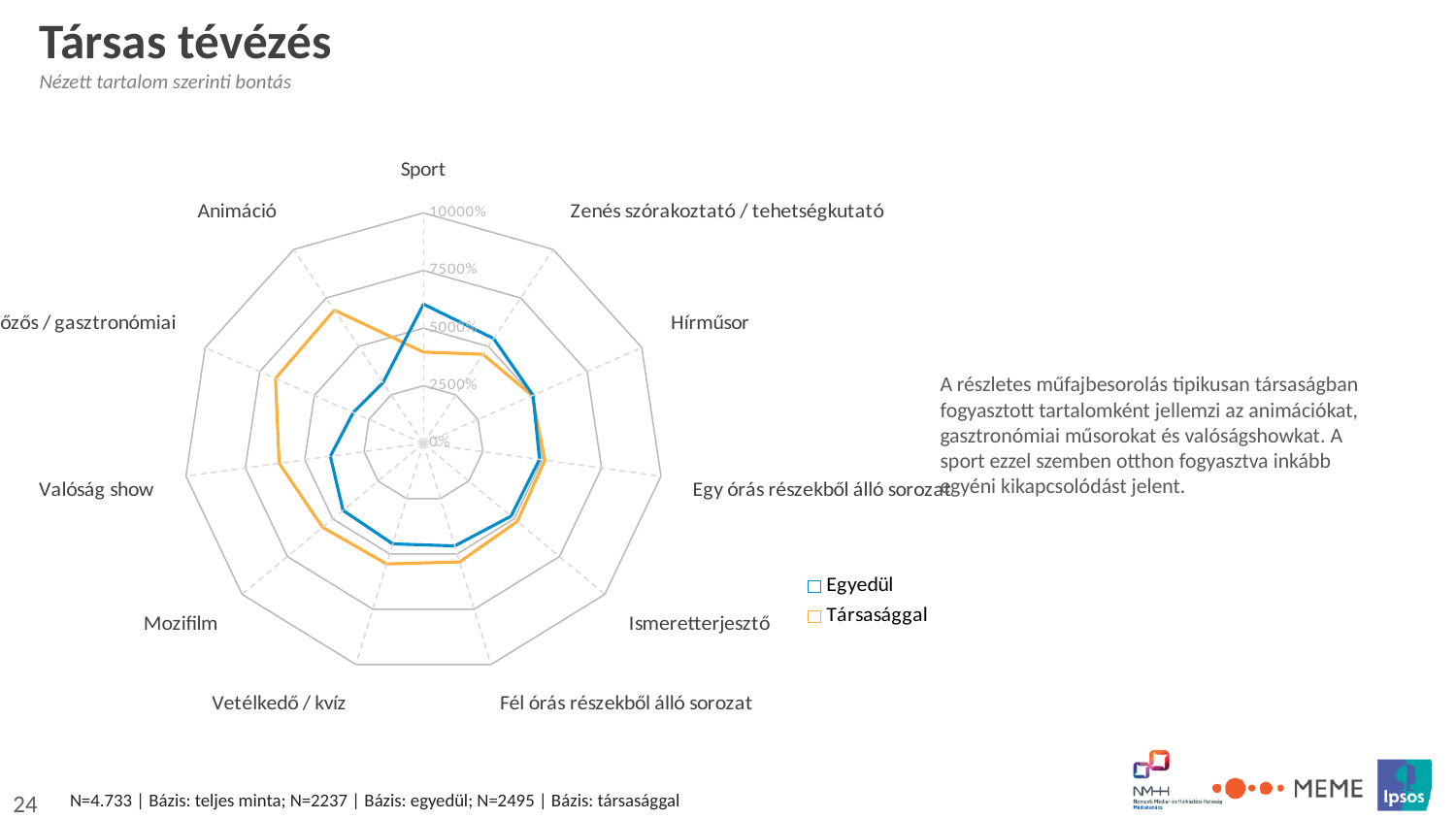
What kind of chart is shown on the slide? radar chart How many categories (axes) does the radar chart have? 11 Which series has the higher value for Animáció, Egyedül or Társasággal? Társasággal What is the highest value shown on the radar chart's axis scale? 10000% What are the two series named in the legend? Egyedül and Társasággal Which series has the higher value for Mozifilm, Egyedül or Társasággal? Társasággal Which series has the higher value for Sport, Egyedül or Társasággal? Egyedül Is the Társasággal value for Animáció greater or less than 5000%? greater How many series does the legend list? 2 Is the Társasággal value for Sport greater or less than 7500%? less Is the Egyedül value for Sport greater or less than 5000%? greater